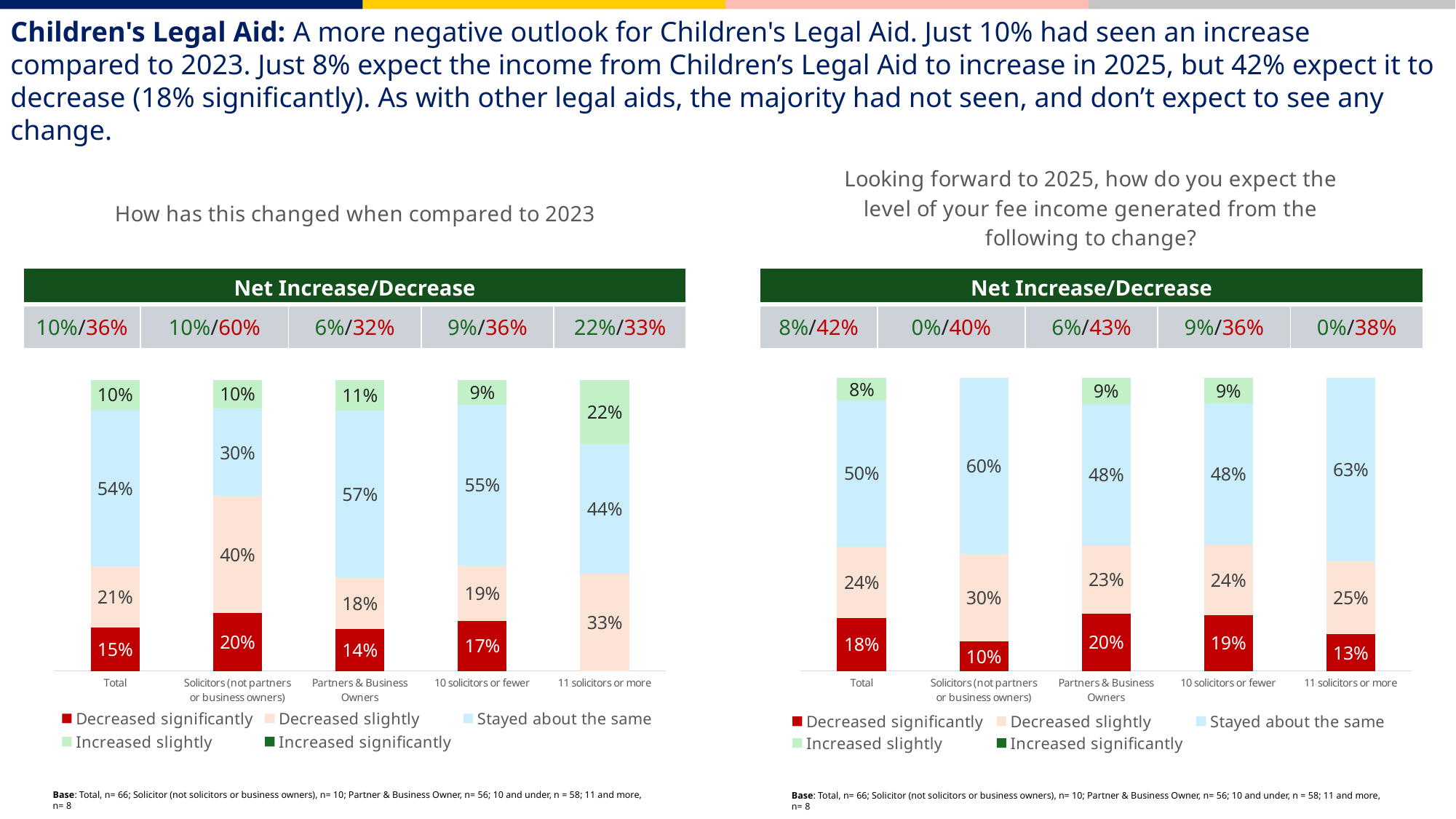
In the left chart (How has this changed when compared to 2023), which category has the highest 'Increased slightly' value? 11 solicitors or more In the right chart (Looking forward to 2025), what percentage of the 11 solicitors or more group expect income to decrease significantly? 13% In the left chart (How has this changed when compared to 2023), is the 'Decreased slightly' value larger for Solicitors (not partners or business owners) or for Partners & Business Owners? Solicitors (not partners or business owners) What type of chart is the right chart (Looking forward to 2025)? Stacked bar chart In the right chart (Looking forward to 2025), which category has the lowest 'Decreased significantly' value? Solicitors (not partners or business owners) In the right chart (Looking forward to 2025), what is the difference between the 'Stayed about the same' values for 11 solicitors or more and Total? 13% In the right chart (Looking forward to 2025), what percentage of the Total group expect income to stay about the same? 50% In the left chart (How has this changed when compared to 2023), what percentage of Solicitors (not partners or business owners) said income decreased slightly? 40% In the left chart (How has this changed when compared to 2023), which category has the highest 'Stayed about the same' value? Partners & Business Owners How many categories are shown along the x axis of the right chart (Looking forward to 2025)? 5 In the left chart (How has this changed when compared to 2023), what percentage of the Total group said their Children's Legal Aid income decreased significantly? 15% How many series does the legend of the left chart (How has this changed when compared to 2023) list? 5